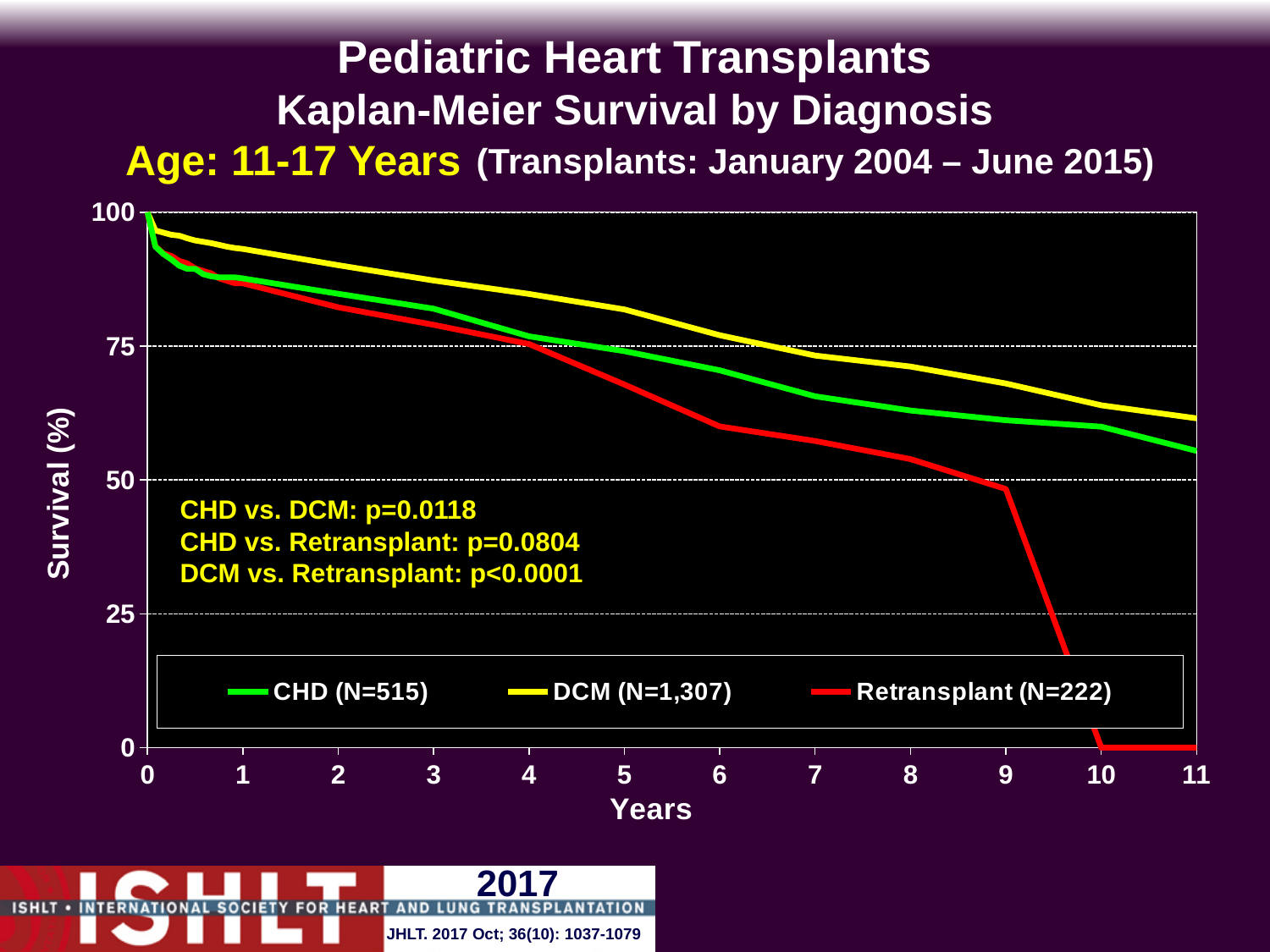
How many series does the legend list? 3 Is the survival value for DCM at 5 years greater or less than 75? greater Is the survival value for Retransplant at 11 years greater or less than 25? less Is the survival value for Retransplant at 6 years greater or less than 50? greater At 8 years, which series has higher survival, DCM or CHD? DCM Which series has the lowest survival at 11 years? Retransplant Do the survival curves rise or fall as years since transplant increase? fall Which series has the highest survival at 11 years? DCM At 10 years, which series has higher survival, CHD or Retransplant? CHD What kind of chart is shown on the slide? line chart What is the p-value shown for DCM vs. Retransplant? p<0.0001